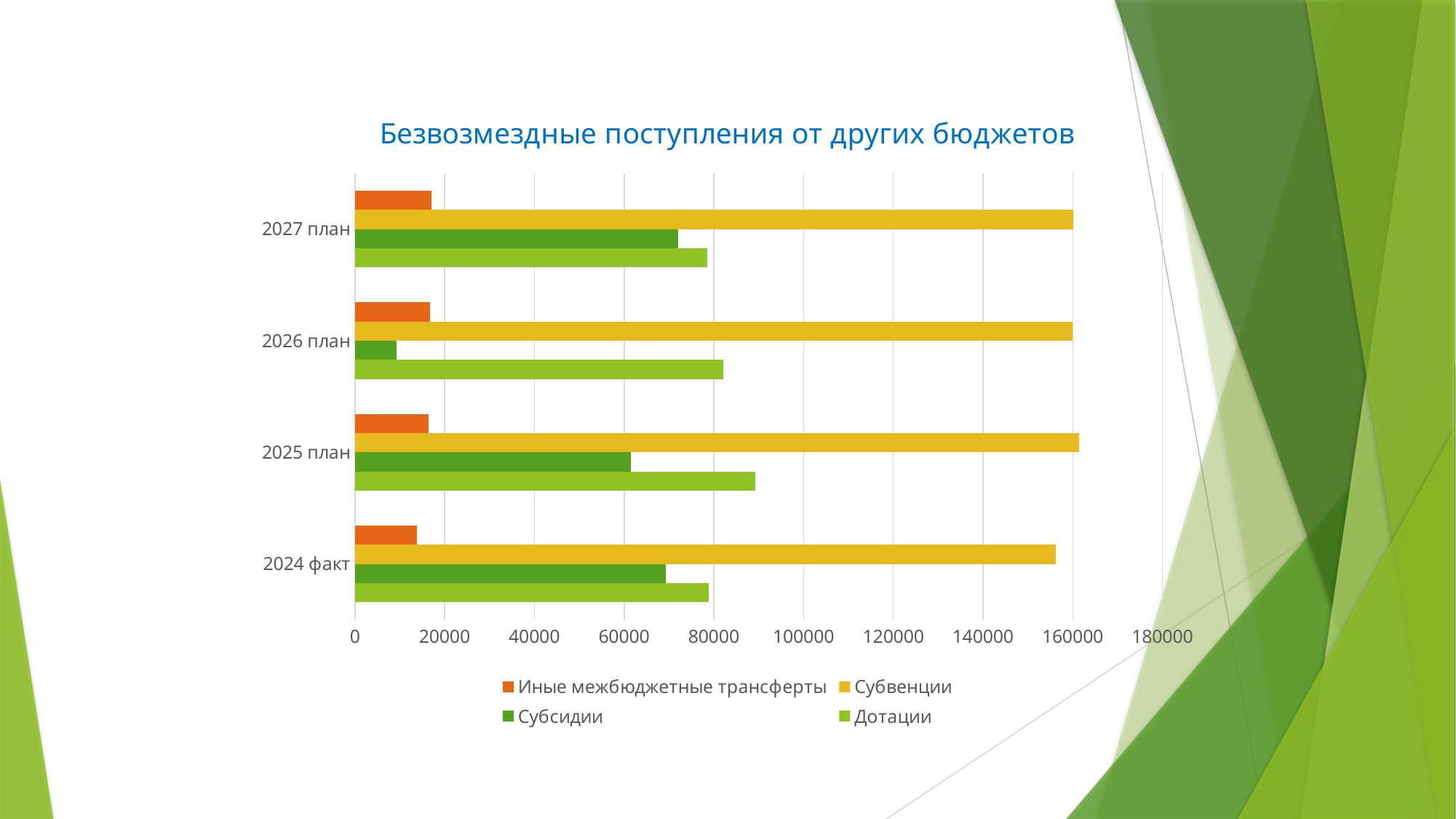
Is the value of Дотации for 2025 план greater or less than 80000? greater Which series has the lowest value for 2024 факт? Иные межбюджетные трансферты What is the title of the chart? Безвозмездные поступления от других бюджетов Which series has the lowest value for 2026 план? Субсидии For 2026 план, which is larger: Дотации or Субсидии? Дотации What kind of chart is shown on the slide? bar chart Is the value of Субсидии for 2027 план greater or less than 60000? greater Which series has the highest value for 2027 план? Субвенции How many series does the legend list? 4 Is the value of Субсидии for 2026 план greater or less than 20000? less How many categories are shown on the vertical axis? 4 Which series is shown in orange in the legend? Иные межбюджетные трансферты